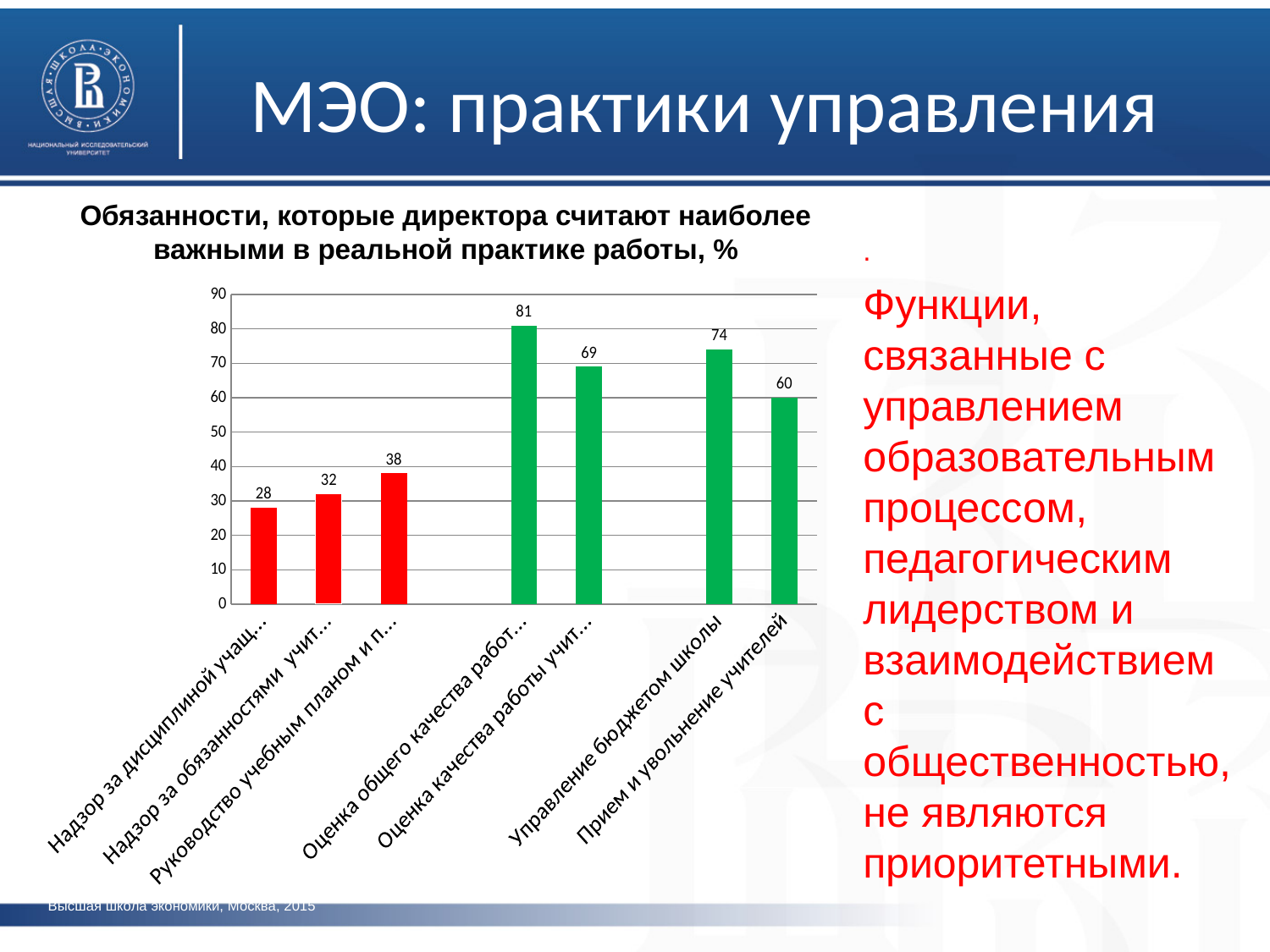
How many bars are plotted in the chart? 7 What kind of chart is shown on the slide? bar chart Which is larger: the value for "Управление бюджетом школы" or the value for "Прием и увольнение учителей"? Управление бюджетом школы What is the value for "Прием и увольнение учителей"? 60 What is the value of the fifth bar from the left ("Оценка качества работы учит...")? 69 What is the value of the highest bar in the chart? 81 What is the value for "Управление бюджетом школы"? 74 What is the value of the lowest bar in the chart? 28 What is the title of the chart? Обязанности, которые директора считают наиболее важными в реальной практике работы, % How many bars in the chart are coloured red? 3 What is the difference between the values for "Управление бюджетом школы" and "Прием и увольнение учителей"? 14 What is the value of the third bar from the left ("Руководство учебным планом и п...")? 38